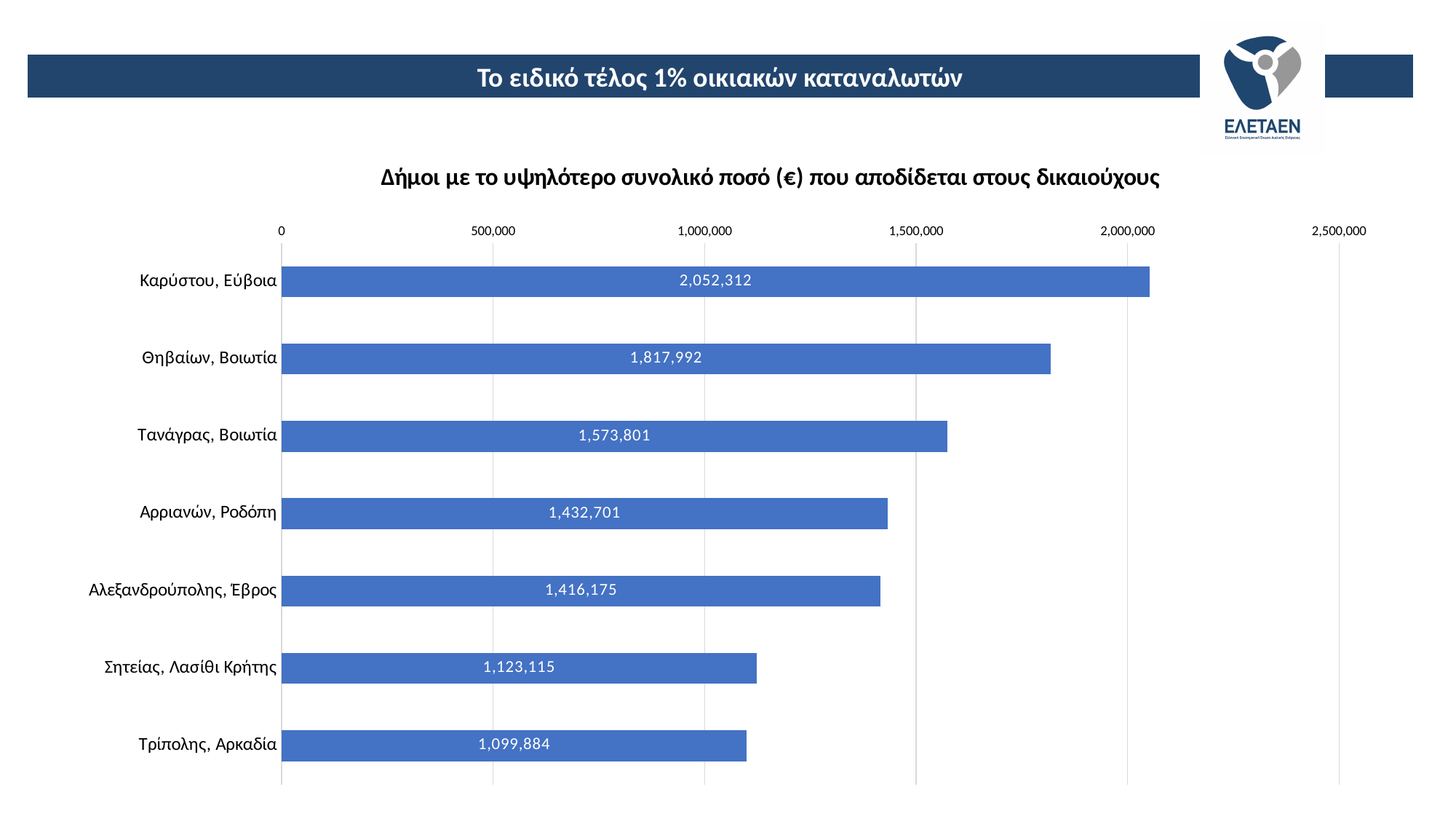
What is the title of the chart? Δήμοι με το υψηλότερο συνολικό ποσό (€) που αποδίδεται στους δικαιούχους Is the value for Τανάγρας, Βοιωτία greater or less than 1,500,000? greater Which municipality has the lowest value? Τρίπολης, Αρκαδία What kind of chart is shown on the slide? bar chart What is the difference between the values for Καρύστου, Εύβοια and Θηβαίων, Βοιωτία? 234,320 How many municipalities are shown in the chart? 7 Which is larger, the value for Θηβαίων, Βοιωτία or the value for Τανάγρας, Βοιωτία? Θηβαίων, Βοιωτία What is the difference between the values for Σητείας, Λασίθι Κρήτης and Τρίπολης, Αρκαδία? 23,231 What is the value for Καρύστου, Εύβοια? 2,052,312 Which municipality has the highest value? Καρύστου, Εύβοια What is the value for Τρίπολης, Αρκαδία? 1,099,884 What is the value for Αλεξανδρούπολης, Έβρος? 1,416,175